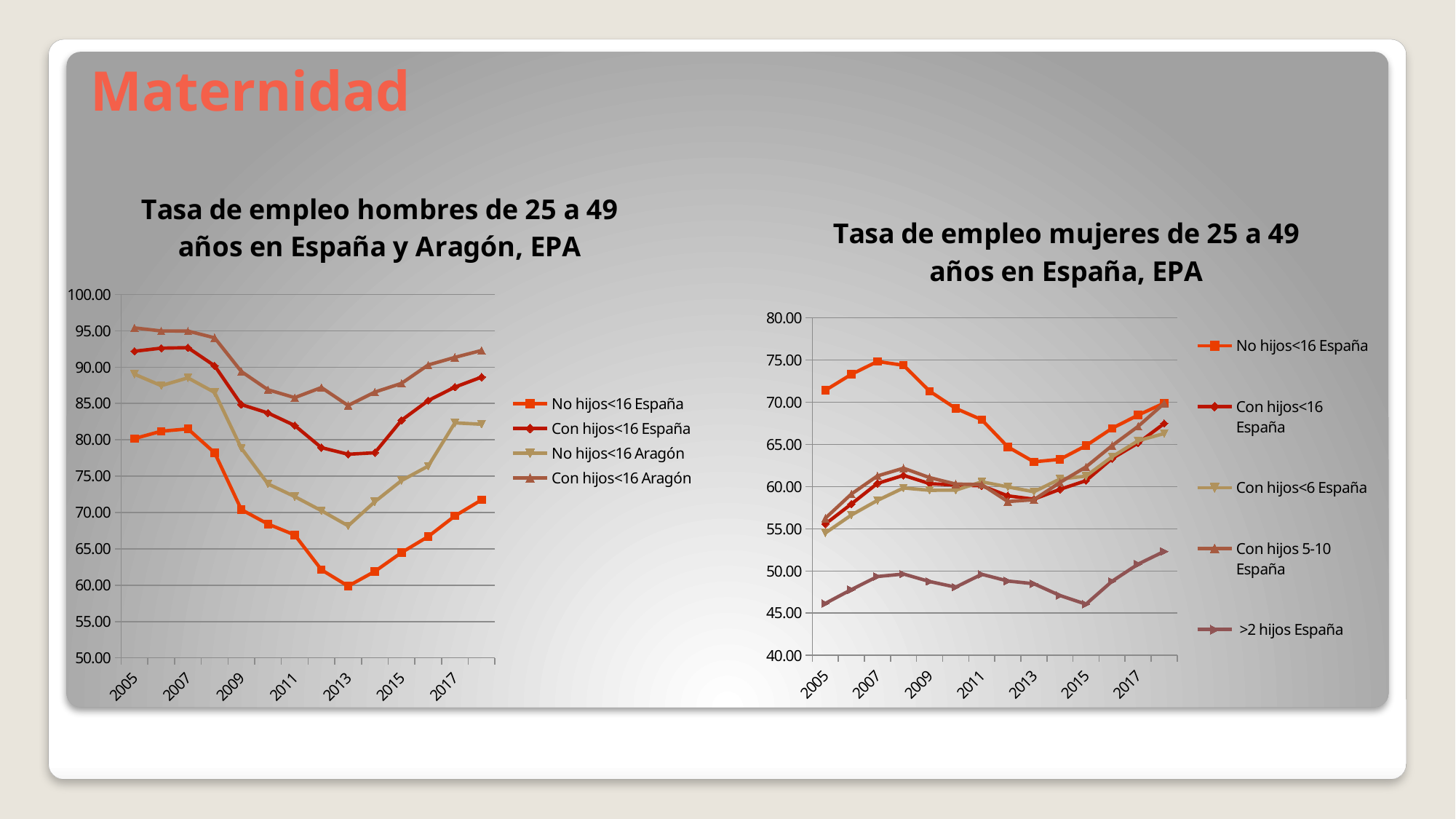
In the right chart (mujeres), which series has the lowest values across all years? >2 hijos España In the left chart (hombres), which is larger in 2013: 'Con hijos<16 Aragón' or 'No hijos<16 España'? Con hijos<16 Aragón How many series does the legend of the right chart (mujeres) list? 5 What kind of chart is the 'Tasa de empleo hombres de 25 a 49 años en España y Aragón, EPA' chart on the left? Line chart In the left chart (hombres), does the 'No hijos<16 España' series rise or fall from 2013 to 2018? Rise In the left chart (hombres), which series has the highest value in 2005? Con hijos<16 Aragón In the right chart (mujeres), does the 'No hijos<16 España' series rise or fall from 2007 to 2013? Fall In the right chart (mujeres), is the value for '>2 hijos España' in 2005 greater or less than 45.00? greater How many series does the legend of the left chart (hombres) list? 4 In the left chart (hombres), is the value for 'Con hijos<16 España' in 2013 greater or less than 80.00? less In the right chart (mujeres), is the value for 'No hijos<16 España' in 2013 greater or less than 60.00? greater